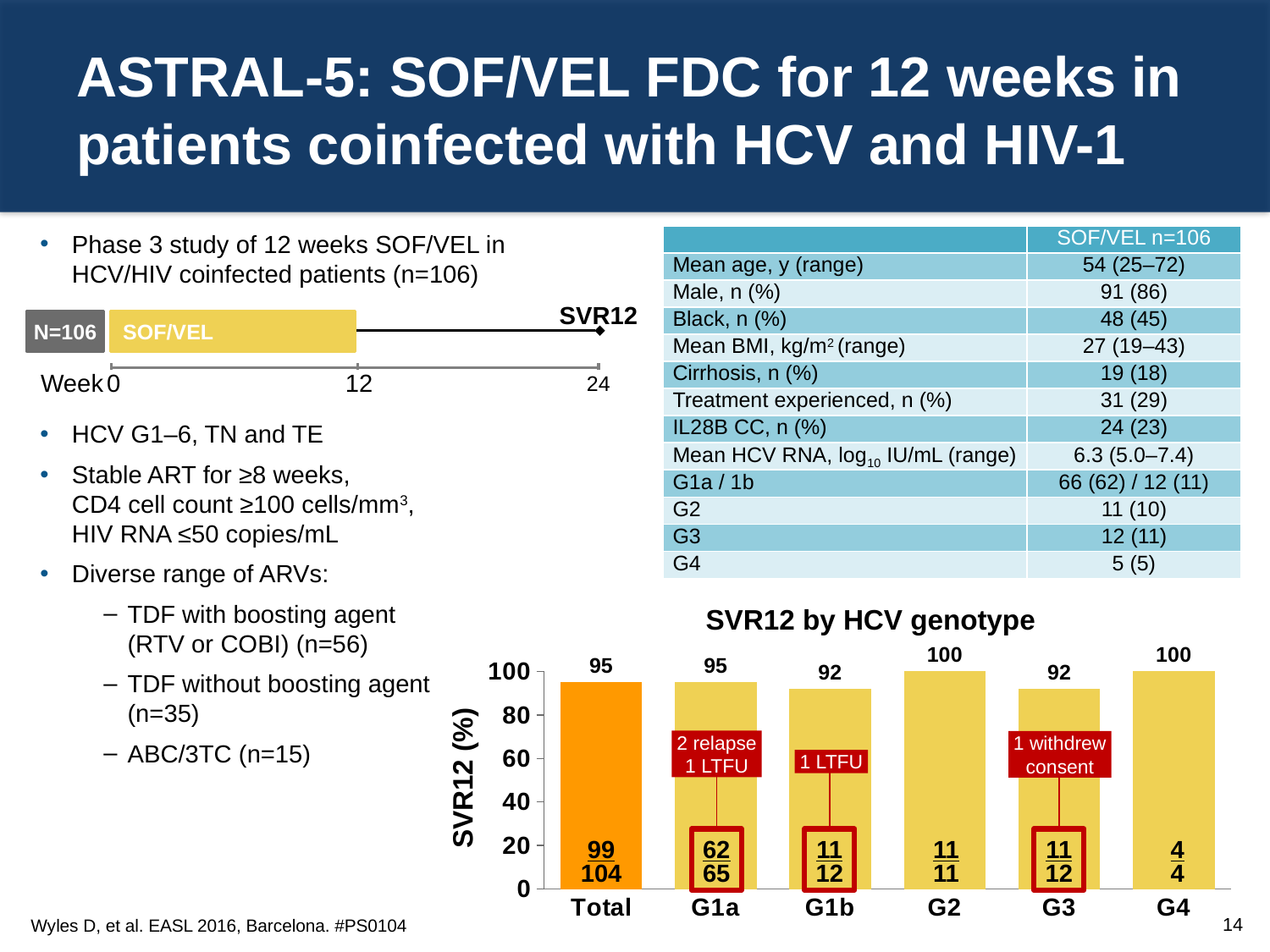
In the 'SVR12 by HCV genotype' chart, how many categories are shown on the x axis? 6 In the 'SVR12 by HCV genotype' chart, what is the y-axis label? SVR12 (%) In the 'SVR12 by HCV genotype' chart, which categories have the highest SVR12 value? G2 and G4 In the 'SVR12 by HCV genotype' chart, what is the SVR12 value for G1b? 92 In the 'SVR12 by HCV genotype' chart, what fraction is printed on the G1a bar? 62/65 In the 'SVR12 by HCV genotype' chart, what is the difference between the SVR12 values for G2 and G3? 8 In the 'SVR12 by HCV genotype' chart, what reason is given in the annotation above the G3 bar? 1 withdrew consent In the 'SVR12 by HCV genotype' chart, which categories have the lowest SVR12 value? G1b and G3 In the 'SVR12 by HCV genotype' chart, which has a higher SVR12 value, G1a or G1b? G1a In the 'SVR12 by HCV genotype' chart, what is the SVR12 value for G2? 100 What kind of chart is 'SVR12 by HCV genotype'? Bar chart In the 'SVR12 by HCV genotype' chart, what is the SVR12 value for Total? 95